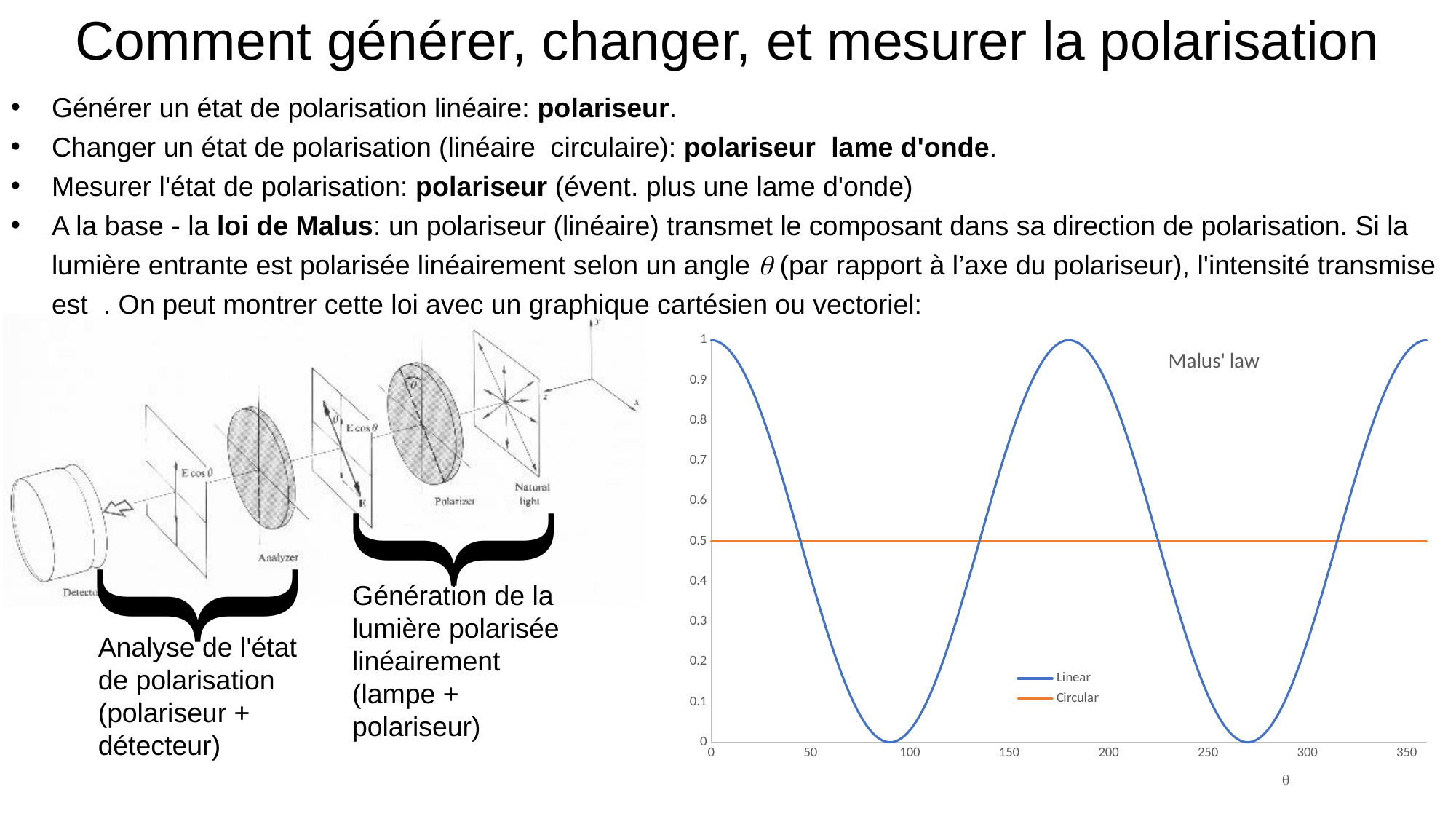
In the Malus' law chart, is the value of the Linear series at θ = 250 greater or less than 0.2? less In the Malus' law chart, is the value of the Linear series at θ = 100 greater or less than 0.1? less Which series in the Malus' law chart is drawn in orange? Circular In the Malus' law chart, what is the lowest value reached by the Linear series? 0 What kind of chart is shown on the right of the slide? line chart In the Malus' law chart, does the Linear series rise or fall as θ goes from 0 to 90? fall In the Malus' law chart, what constant value does the Circular series take? 0.5 In the Malus' law chart, is the value of the Linear series at θ = 150 greater or less than 0.5? greater In the Malus' law chart, at θ = 150, which series has the larger value, Linear or Circular? Linear How many series does the legend of the Malus' law chart list? 2 In the Malus' law chart, what is the value of the Linear series at θ = 0? 1 What is the title of the chart on the right of the slide? Malus' law